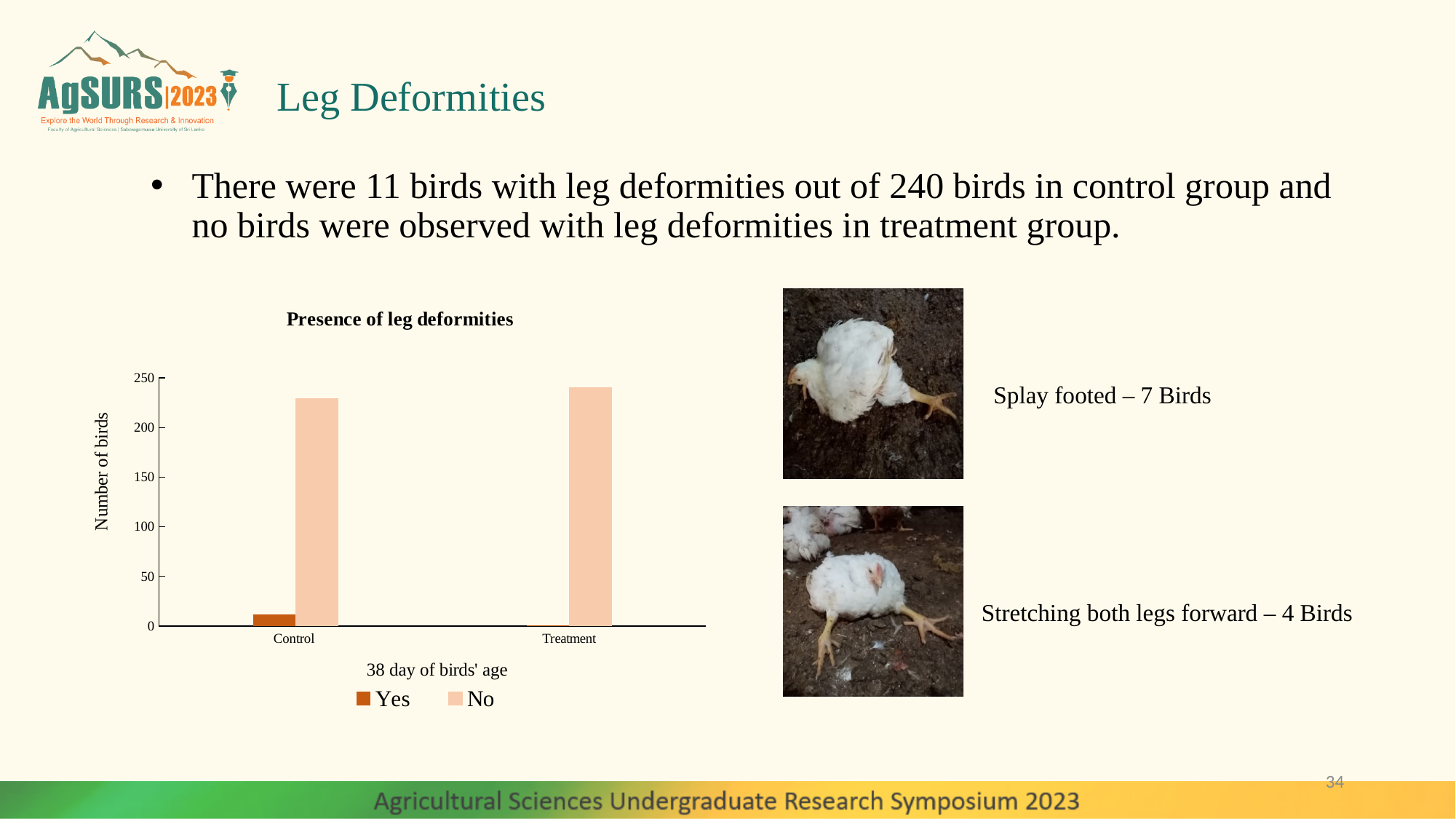
Which category has the lower "Yes" value, Control or Treatment? Treatment For the Control group, which series has the larger value, Yes or No? No Is the value of the "No" bar for Control greater or less than 200? greater Is the value of the "Yes" bar for Control greater or less than 50? less What are the two series listed in the chart's legend? Yes and No Which category has the higher "Yes" value, Control or Treatment? Control How many series does the chart's legend list? 2 What is the title of the chart? Presence of leg deformities How many categories are shown on the x axis of the chart? 2 What is the label on the y axis of the chart? Number of birds What kind of chart is shown on the slide? bar chart Is the value of the "No" bar for Treatment greater or less than 200? greater